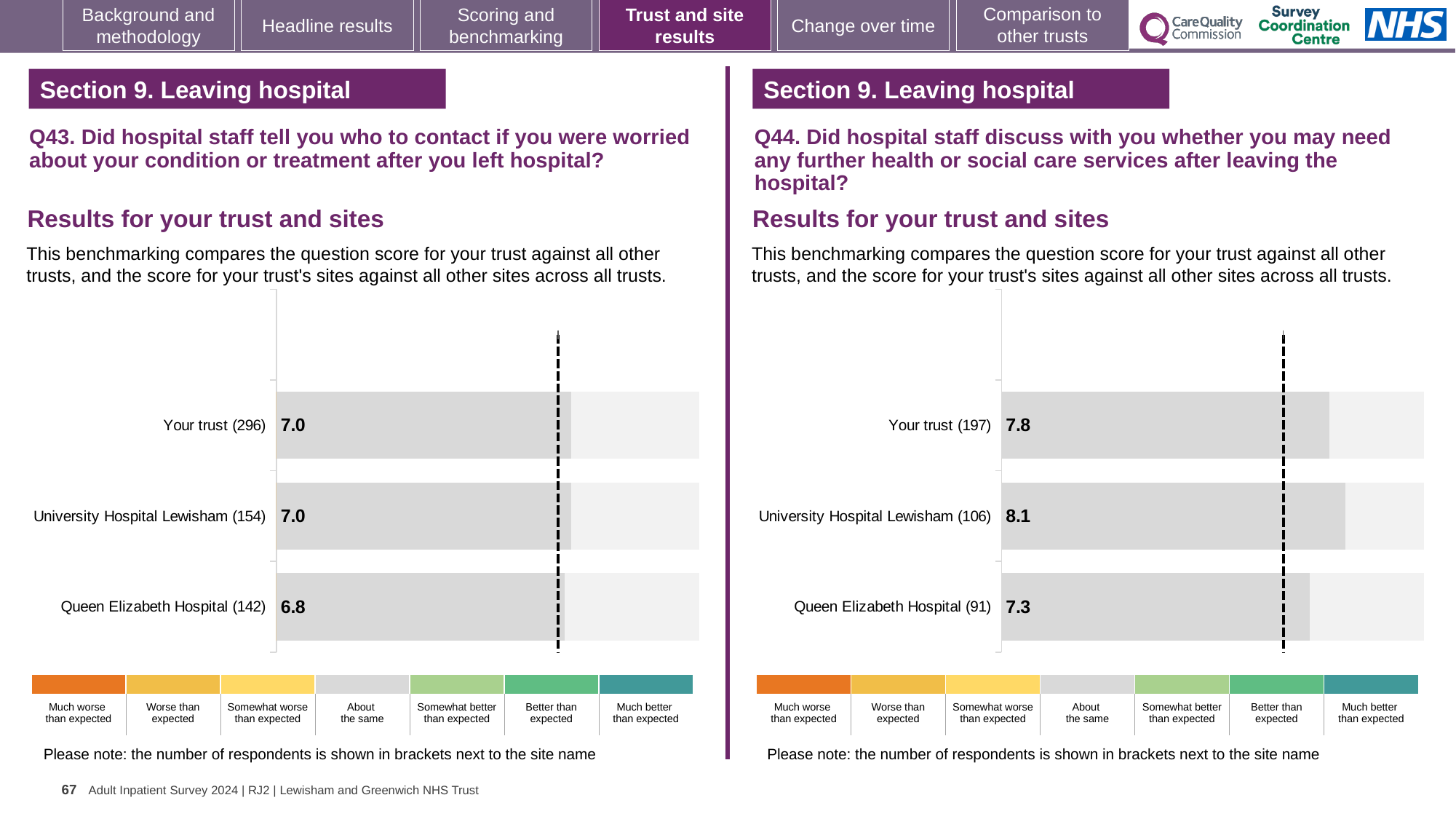
On the Q43 chart (left), which site or trust has the lowest score? Queen Elizabeth Hospital On the Q44 chart (right), what is the difference between the scores for University Hospital Lewisham and Queen Elizabeth Hospital? 0.8 On the Q44 chart (right), which site or trust has the lowest score? Queen Elizabeth Hospital How many bars are plotted on the Q43 chart (left)? 3 On the Q43 chart (left), what is the difference between the scores for Your trust and Queen Elizabeth Hospital? 0.2 On the Q44 chart (right), what is the score for Queen Elizabeth Hospital? 7.3 On the Q43 chart (left), what is the score for Your trust? 7.0 On the Q43 chart (left), what is the score for Queen Elizabeth Hospital? 6.8 What kind of chart is used on the Q44 chart (right)? Bar chart On the Q44 chart (right), what is the score for University Hospital Lewisham? 8.1 On the Q44 chart (right), which has the larger score, Your trust or Queen Elizabeth Hospital? Your trust On the Q44 chart (right), which site or trust has the highest score? University Hospital Lewisham